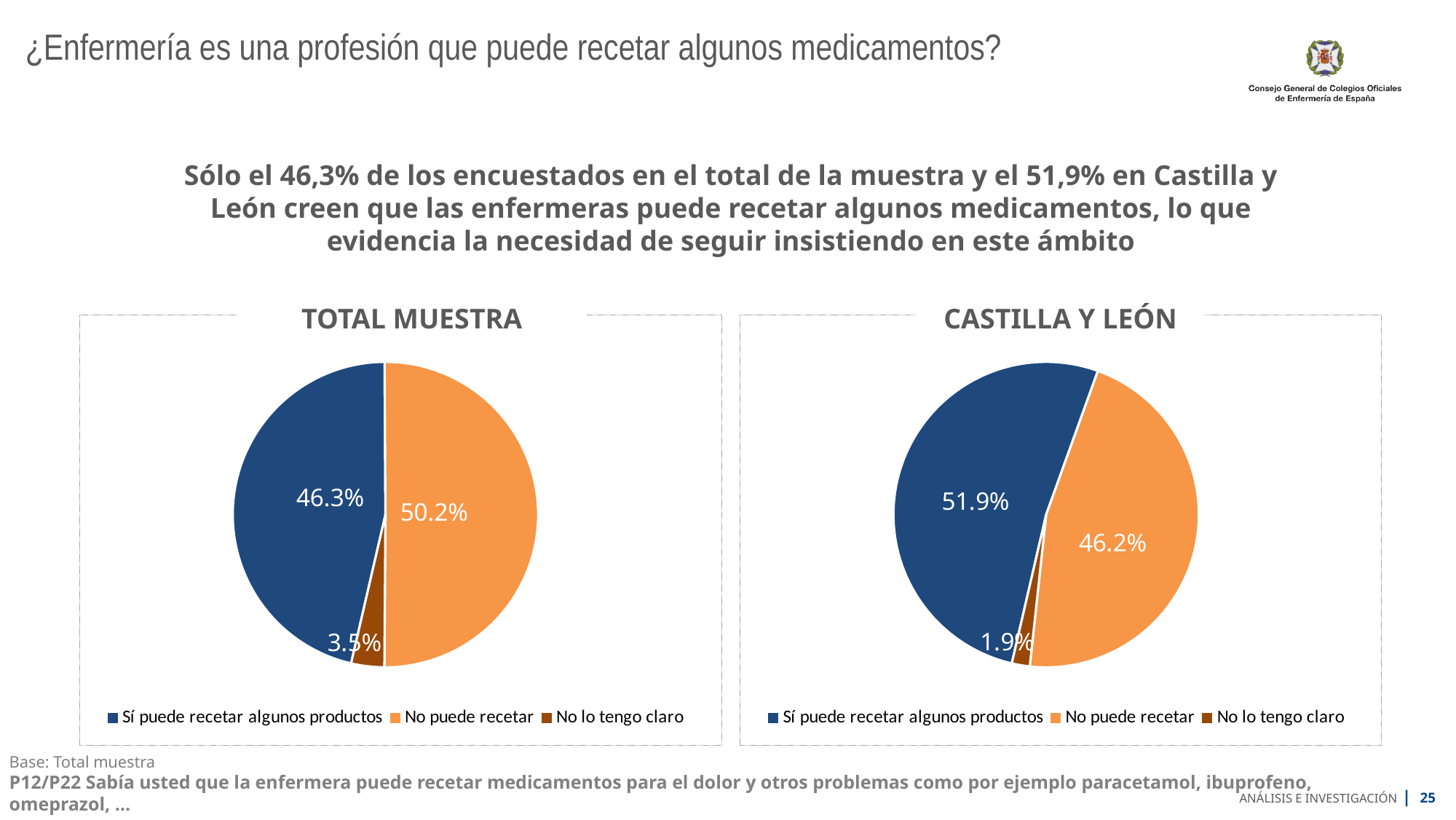
What type of chart is used for CASTILLA Y LEÓN? Pie chart In the CASTILLA Y LEÓN chart, what percentage corresponds to "No lo tengo claro"? 1.9% In the TOTAL MUESTRA chart, which colour represents "No lo tengo claro"? Dark brown In the CASTILLA Y LEÓN chart, what percentage corresponds to "Sí puede recetar algunos productos"? 51.9% In the TOTAL MUESTRA chart, what percentage corresponds to "Sí puede recetar algunos productos"? 46.3% In the CASTILLA Y LEÓN chart, what is the difference between "Sí puede recetar algunos productos" and "No puede recetar"? 5.7% In the TOTAL MUESTRA chart, what is the difference between "No puede recetar" and "No lo tengo claro"? 46.7% Which chart shows a larger value for "Sí puede recetar algunos productos", TOTAL MUESTRA or CASTILLA Y LEÓN? CASTILLA Y LEÓN In the CASTILLA Y LEÓN chart, which category has the smallest slice? No lo tengo claro In the TOTAL MUESTRA chart, what percentage corresponds to "No puede recetar"? 50.2% In the TOTAL MUESTRA chart, which category has the largest slice? No puede recetar How many categories does the TOTAL MUESTRA chart show? 3